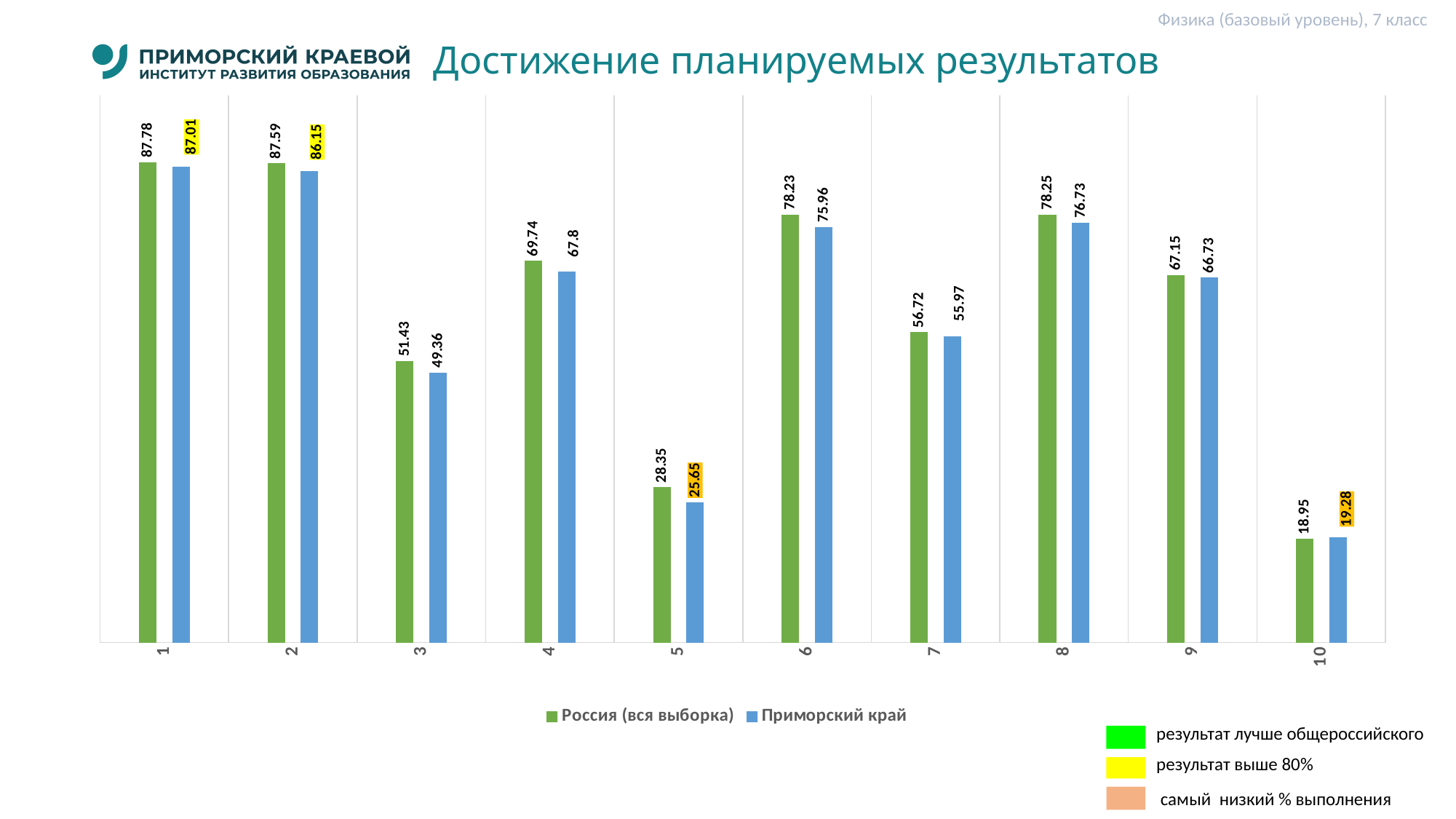
What is the value for Россия (вся выборка) for task 4? 69.74 Which task has the highest value for Приморский край? 1 What is the difference between Россия (вся выборка) and Приморский край for task 3? 2.07 How many tasks (categories) are shown on the x axis? 10 Which task has the lowest value for Россия (вся выборка)? 10 What is the value for Приморский край for task 5? 25.65 What is the title of the chart on the slide? Достижение планируемых результатов For task 10, which series has the larger value: Россия (вся выборка) or Приморский край? Приморский край How many series does the chart legend list? 2 What is the value for Приморский край for task 10? 19.28 What kind of chart is shown on the slide? Bar chart For task 6, which series has the larger value: Россия (вся выборка) or Приморский край? Россия (вся выборка)